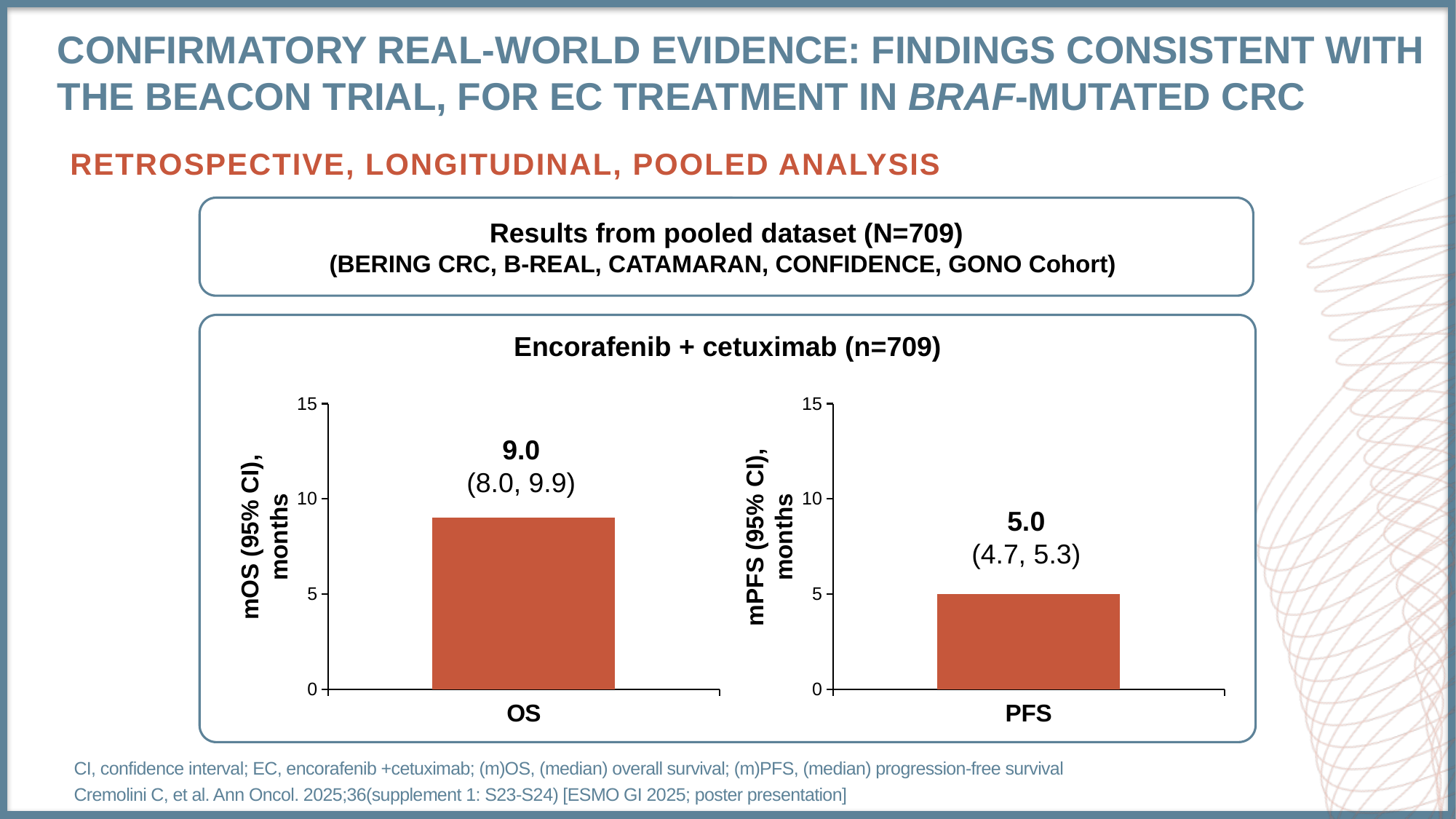
In the left chart (OS), is the value for OS greater or less than 10? less In the left chart (OS), what is the median overall survival value shown for the OS bar? 9.0 What is the y-axis label of the left chart (OS)? mOS (95% CI), months In the right chart (PFS), what is the median progression-free survival value shown for the PFS bar? 5.0 What kind of chart is the left chart (OS)? Bar chart How many bars are plotted in the right chart (PFS)? 1 What is the difference between the mOS value in the left chart and the mPFS value in the right chart? 4.0 In the left chart (OS), what is the 95% confidence interval printed above the OS bar? (8.0, 9.9) In the right chart (PFS), is the value for PFS greater or less than 10? less In the right chart (PFS), what is the 95% confidence interval printed above the PFS bar? (4.7, 5.3) What is the maximum value shown on the y-axis of the right chart (PFS)? 15 Which is larger: the OS value in the left chart or the PFS value in the right chart? OS